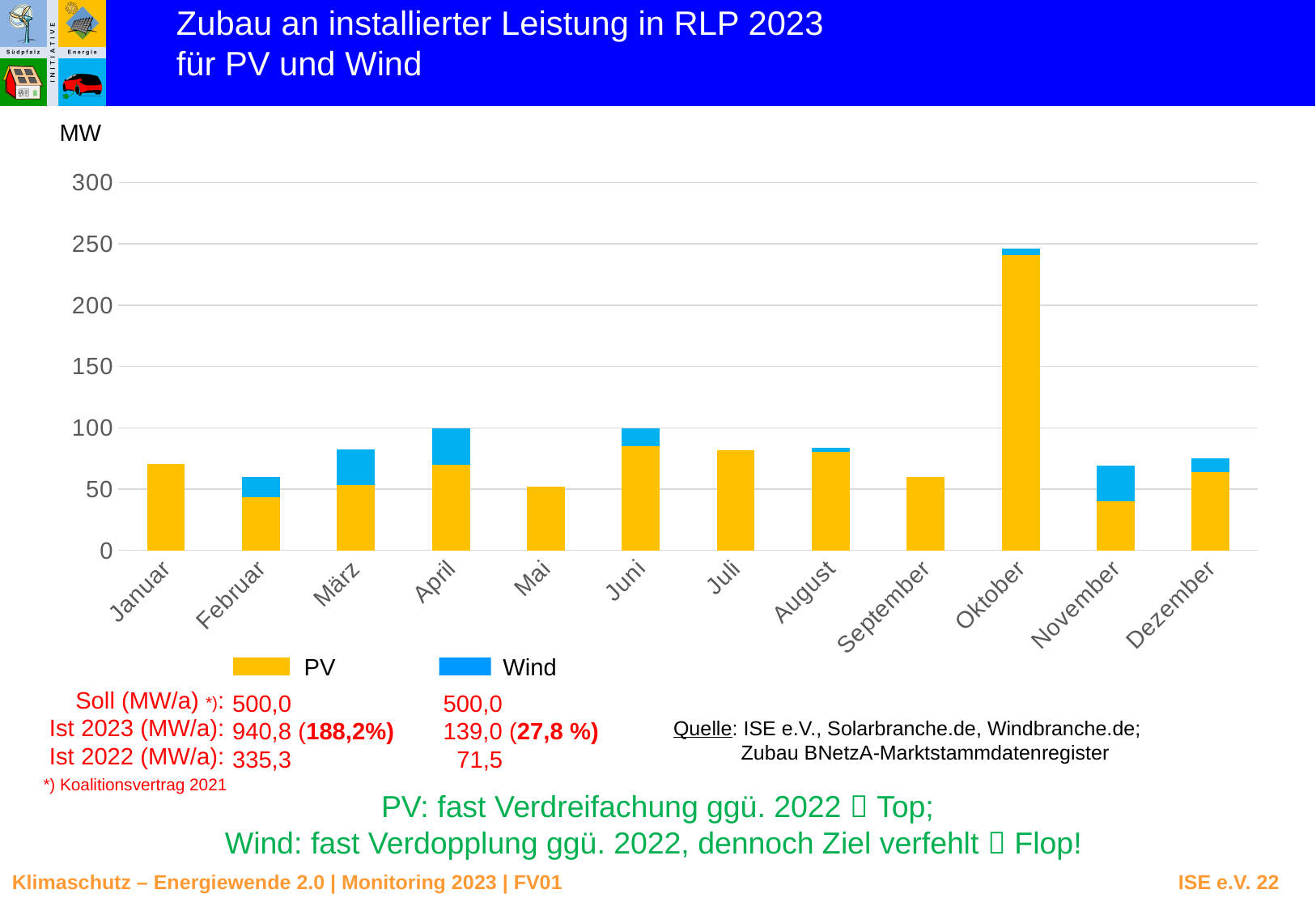
Which month has the larger total, Oktober or Januar? Oktober What unit is shown on the y axis? MW How many series does the legend list? 2 Is the total value for Juli greater or less than 100? less What kind of chart is shown on the slide? bar chart Which month has the larger total, März or Mai? März Is the total value for Mai greater or less than 100? less Which month has the highest total installed capacity added? Oktober How many months (categories) are shown on the x axis? 12 Is the total value for Oktober greater or less than 200? greater What are the two series named in the legend? PV and Wind